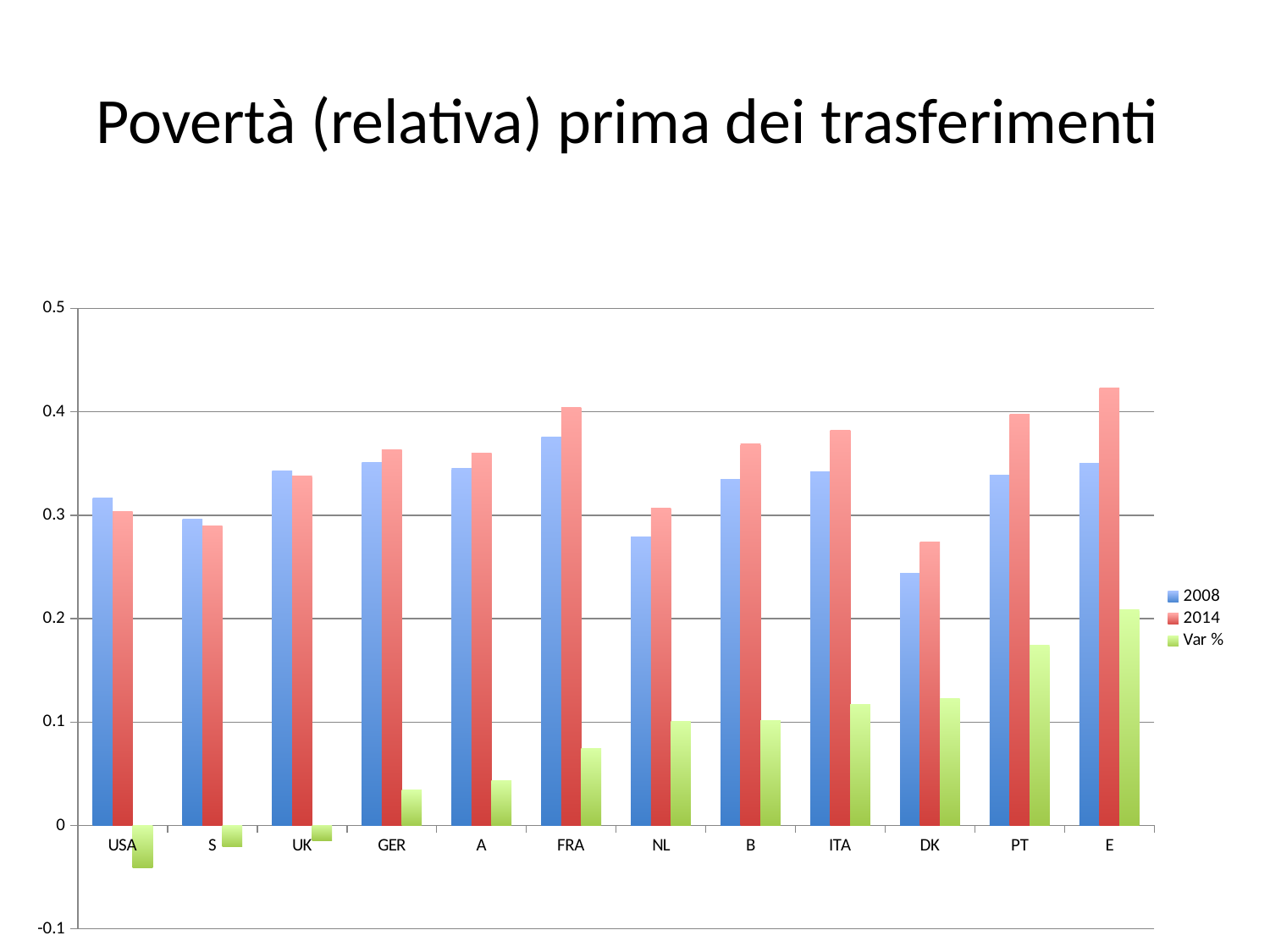
Is the Var % value for PT greater or less than 0.1? greater What is the title of the chart? Povertà (relativa) prima dei trasferimenti Which country has the lowest value for the 2008 series? DK For DK, which is larger: the 2008 value or the 2014 value? 2014 How many countries (categories) are shown on the x axis? 12 How many series does the legend list? 3 Which country has the highest value for the 2014 series? E What kind of chart is shown on the slide? bar chart Which country has the highest value for the 2008 series? FRA Which country has the lowest value for the Var % series? USA Is the 2014 value for E greater or less than 0.4? greater Is the 2014 value for DK greater or less than 0.3? less